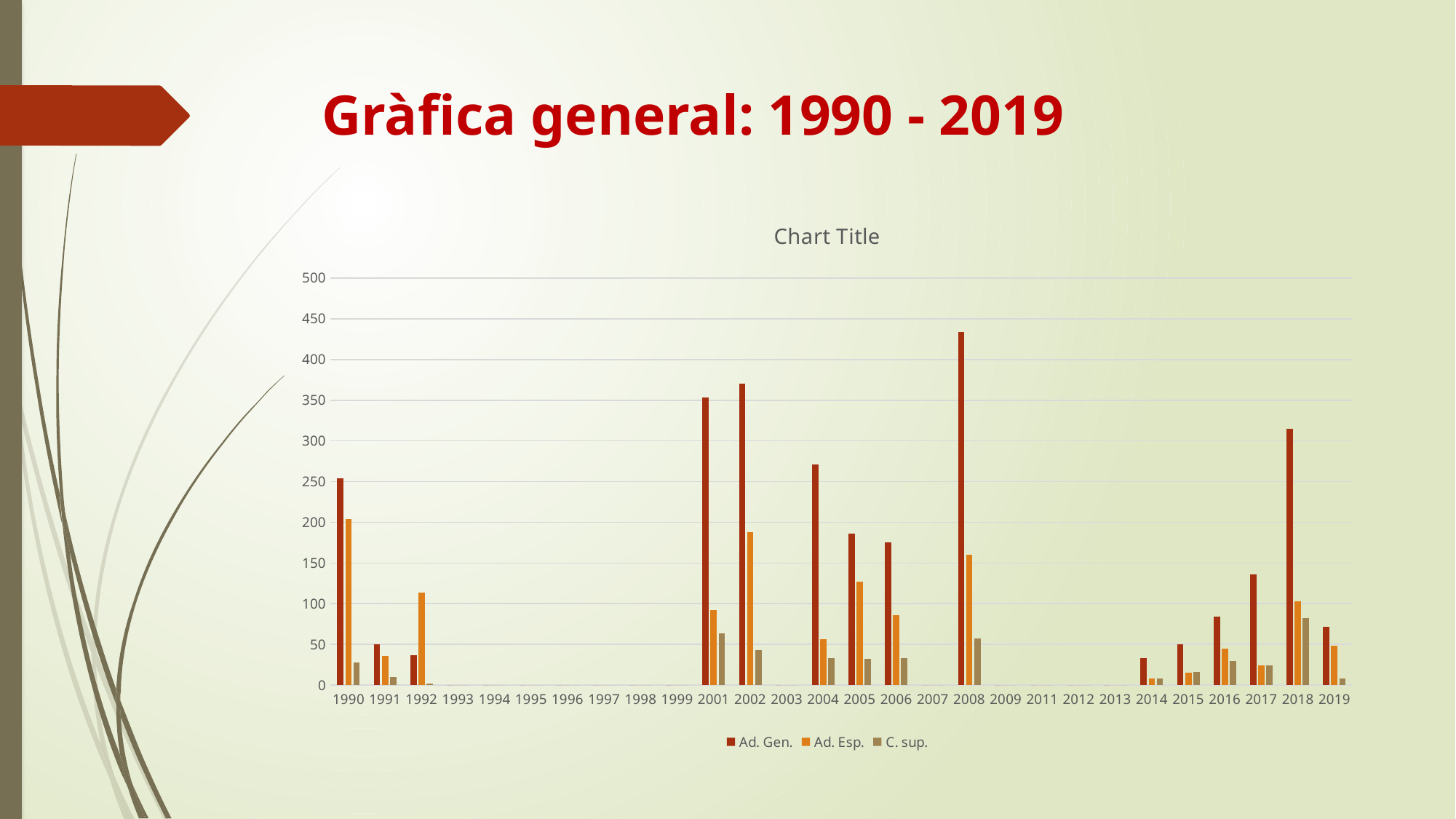
What kind of chart is shown on the slide? Bar chart In which year is the C. sup. value highest? 2018 Is the Ad. Gen. value for 2018 greater or less than 300? greater In which year is the Ad. Gen. value highest? 2008 Is the Ad. Gen. value for 2017 greater or less than 150? less How many series does the chart's legend list? 3 How many year categories are shown on the x axis of the chart? 28 In which year is the Ad. Esp. value highest? 1990 Is the Ad. Gen. value for 2008 greater or less than 400? greater What title is printed above the chart's plot area? Chart Title Which is larger, the Ad. Gen. value for 2008 or the Ad. Gen. value for 2018? 2008